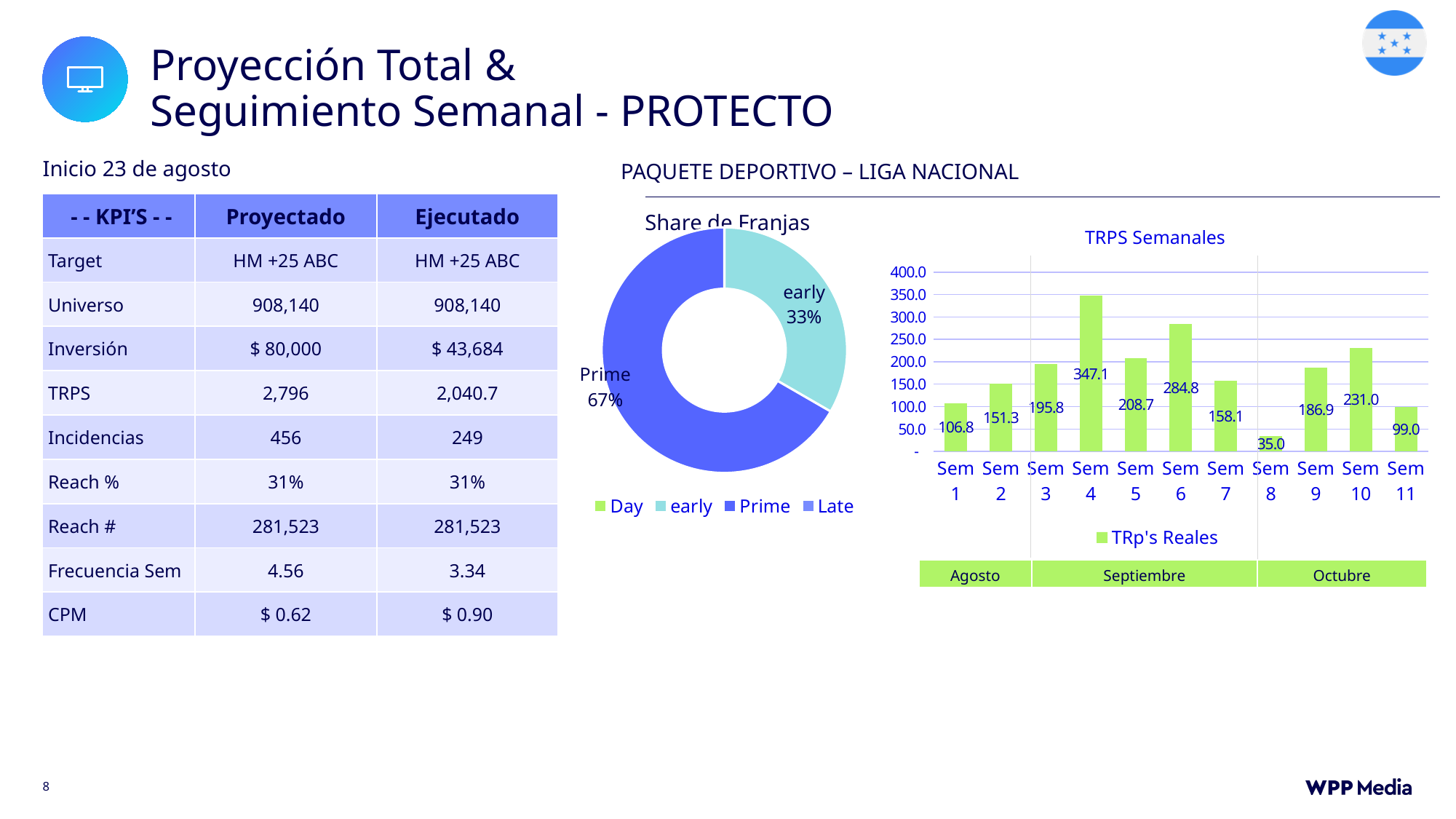
In the 'TRPS Semanales' chart, what is the name of the series shown in the legend? TRp's Reales In the 'TRPS Semanales' chart, what is the value for Sem 4? 347.1 In the 'TRPS Semanales' chart, what is the difference between the values for Sem 6 and Sem 7? 126.7 In the 'Share de Franjas' chart, what share does early have? 33% What kind of chart is 'TRPS Semanales'? Bar chart In the 'TRPS Semanales' chart, what is the value for Sem 8? 35.0 In the 'Share de Franjas' chart, what share does Prime have? 67% In the 'TRPS Semanales' chart, which week has the lowest value? Sem 8 In the 'TRPS Semanales' chart, which is larger, the value for Sem 10 or the value for Sem 9? Sem 10 In the 'TRPS Semanales' chart, which week has the highest value? Sem 4 In the 'TRPS Semanales' chart, how many weeks are plotted? 11 How many entries does the legend of the 'Share de Franjas' chart list? 4